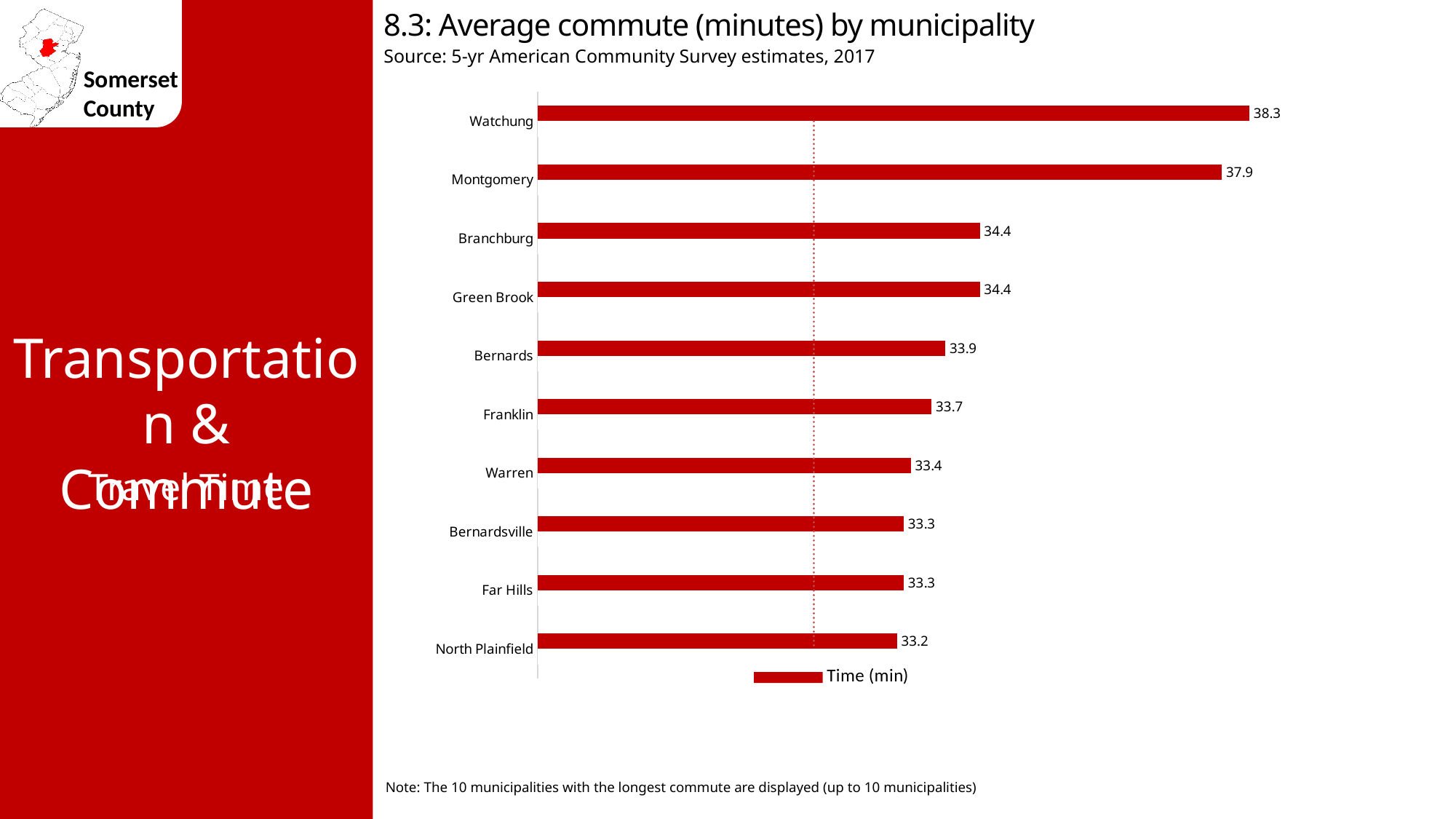
How many municipalities are shown in the chart? 10 What is the average commute time for Watchung? 38.3 Which has a longer average commute, Franklin or Warren? Franklin How many series does the legend list? 1 What is the average commute time for Bernards? 33.9 What is the difference in average commute time between Watchung and Montgomery? 0.4 What is the legend entry for the series in the chart? Time (min) What is the average commute time for North Plainfield? 33.2 Which municipality has the shortest average commute among those shown? North Plainfield Which municipality has the longest average commute? Watchung What is the difference in average commute time between Branchburg and North Plainfield? 1.2 What kind of chart is shown? Bar chart